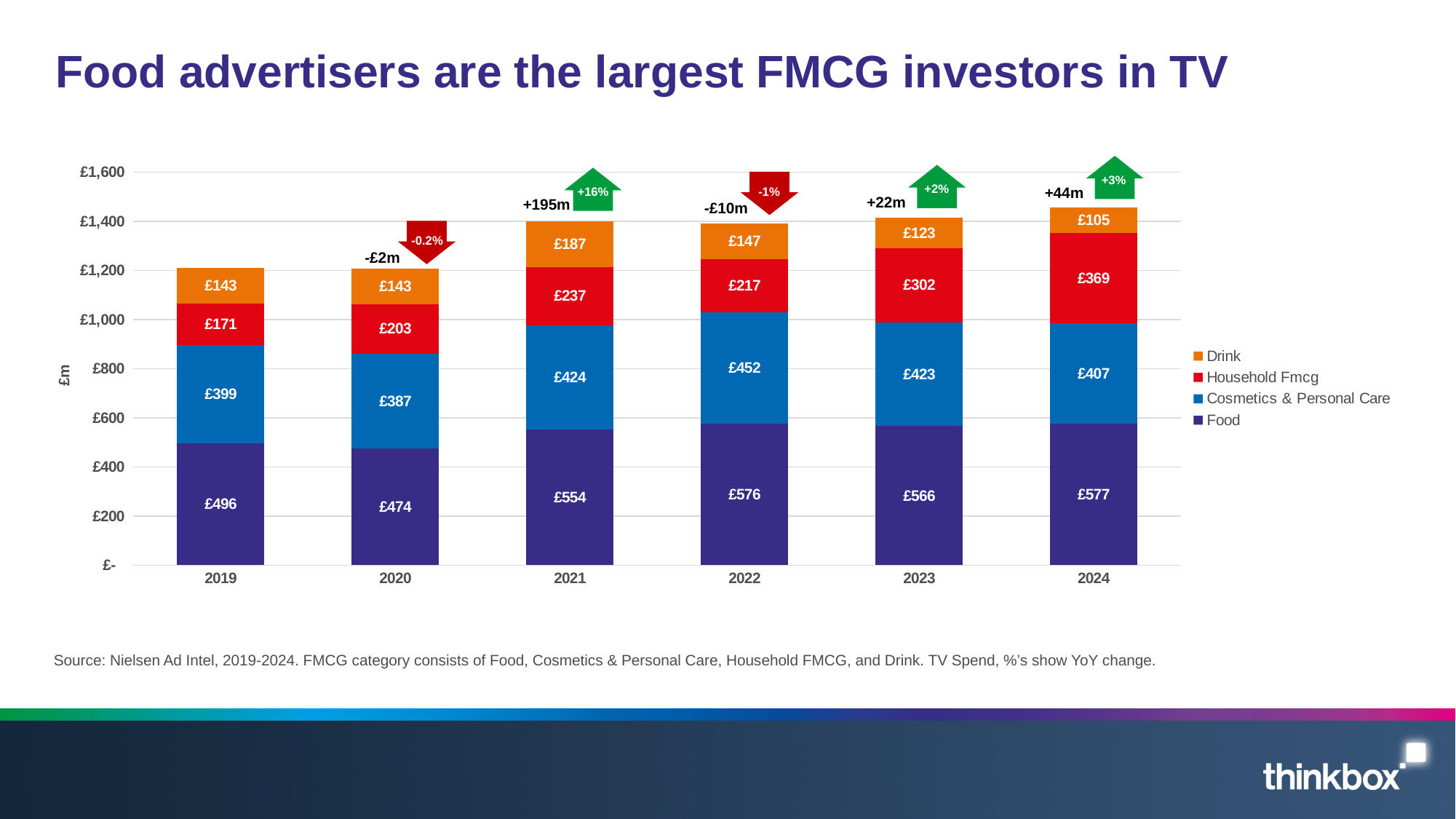
What is the value for Household Fmcg in 2021? £237 Which is larger, the Food value in 2019 or the Food value in 2020? 2019 What kind of chart is shown on the slide? Stacked bar chart What is the value for Food in 2024? £577 What is the difference between the Cosmetics & Personal Care values in 2022 and 2020? £65 What year-on-year percentage change is shown above the 2021 bar? +16% In which year is the Drink value lowest? 2024 What is the value for Drink in 2022? £147 What is the total of the stacked bar for 2024? £1,458 In which year is the Household Fmcg value highest? 2024 How many series does the legend list? 4 How many years are shown on the x axis? 6